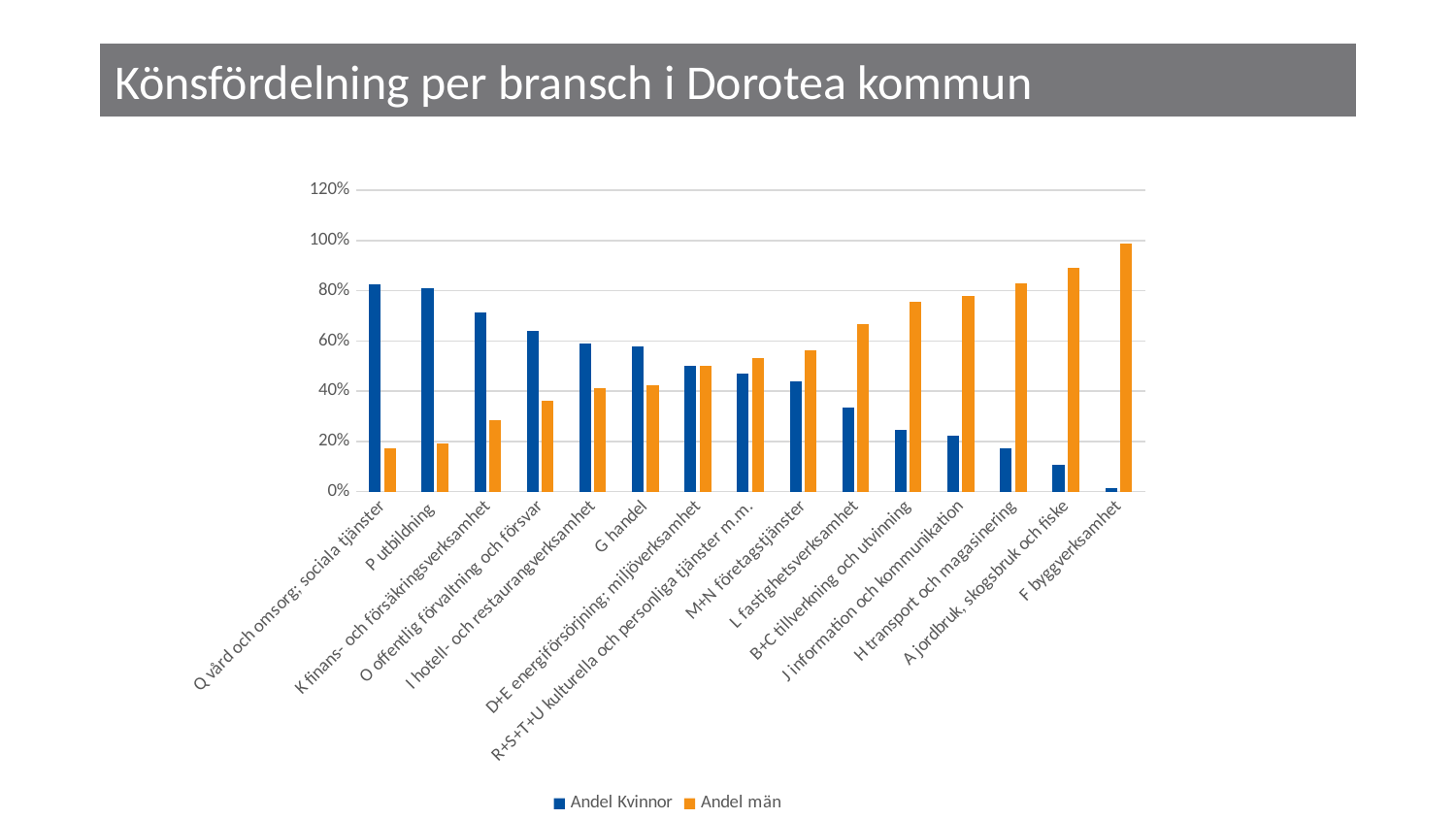
Which category has the lowest value for Andel Kvinnor? F byggverksamhet For L fastighetsverksamhet, which is larger: Andel Kvinnor or Andel män? Andel män What kind of chart is shown on the slide? Bar chart Is the Andel män value for B+C tillverkning och utvinning greater or less than 60%? greater Is the Andel Kvinnor value for K finans- och försäkringsverksamhet greater or less than 60%? greater Is the Andel män value for O offentlig förvaltning och försvar greater or less than 40%? less Do the Andel Kvinnor values generally rise or fall from left to right along the x axis? Fall For I hotell- och restaurangverksamhet, which is larger: Andel Kvinnor or Andel män? Andel Kvinnor How many series does the legend list? 2 Which category has the highest value for Andel män? F byggverksamhet How many industry categories are shown on the x axis? 15